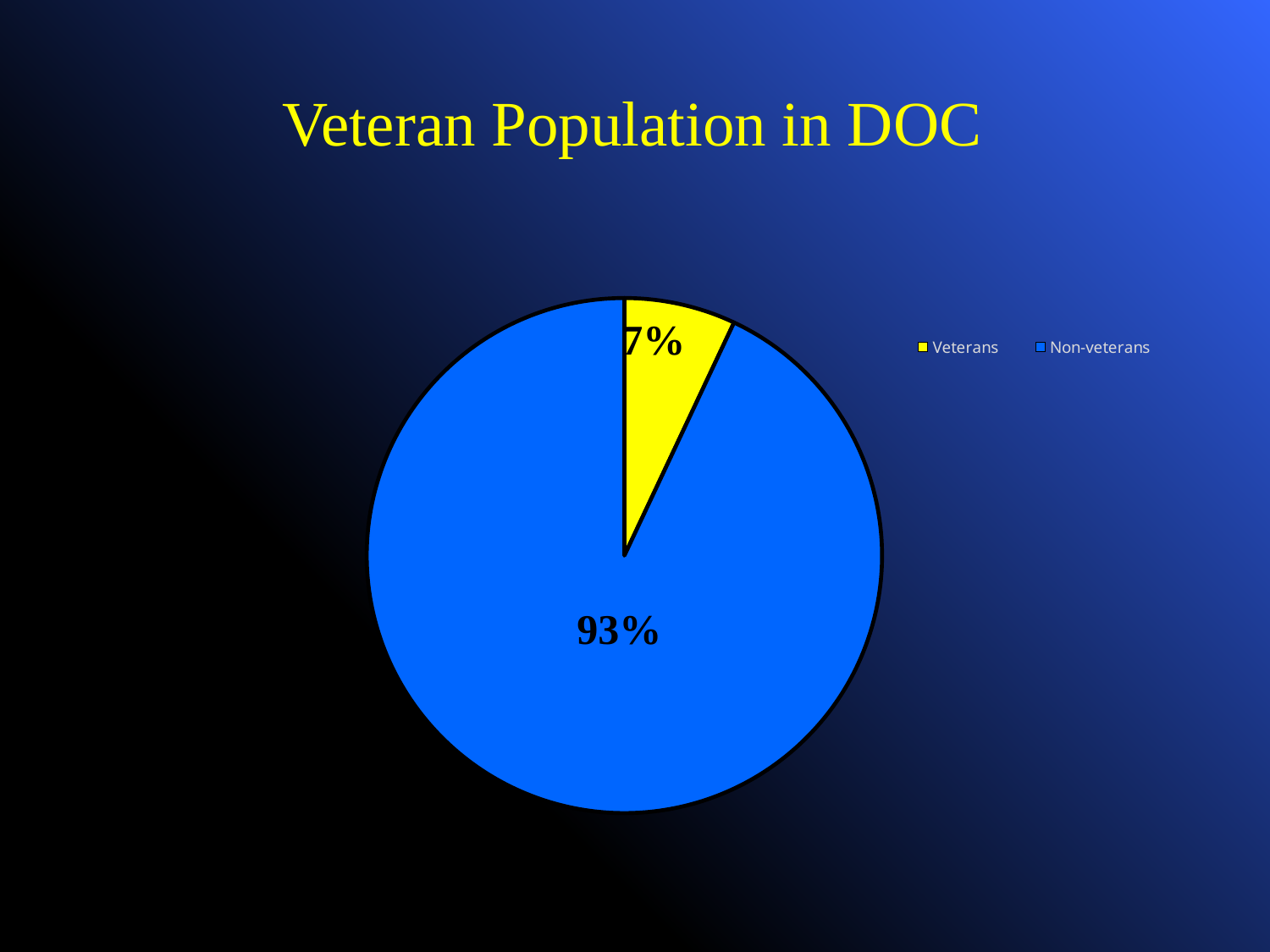
What is the title of the chart? Veteran Population in DOC What is the difference in percentage points between the Non-veterans and Veterans slices? 86 What kind of chart is shown on the slide? pie chart Which is larger, the Veterans slice or the Non-veterans slice? Non-veterans How many entries does the legend list? 2 What share of the pie do Veterans make up? 7% Which category has the largest slice of the pie? Non-veterans What share of the pie do Non-veterans make up? 93% What colour is the Veterans slice? yellow How many categories does the pie chart show? 2 Which category has the smallest slice of the pie? Veterans